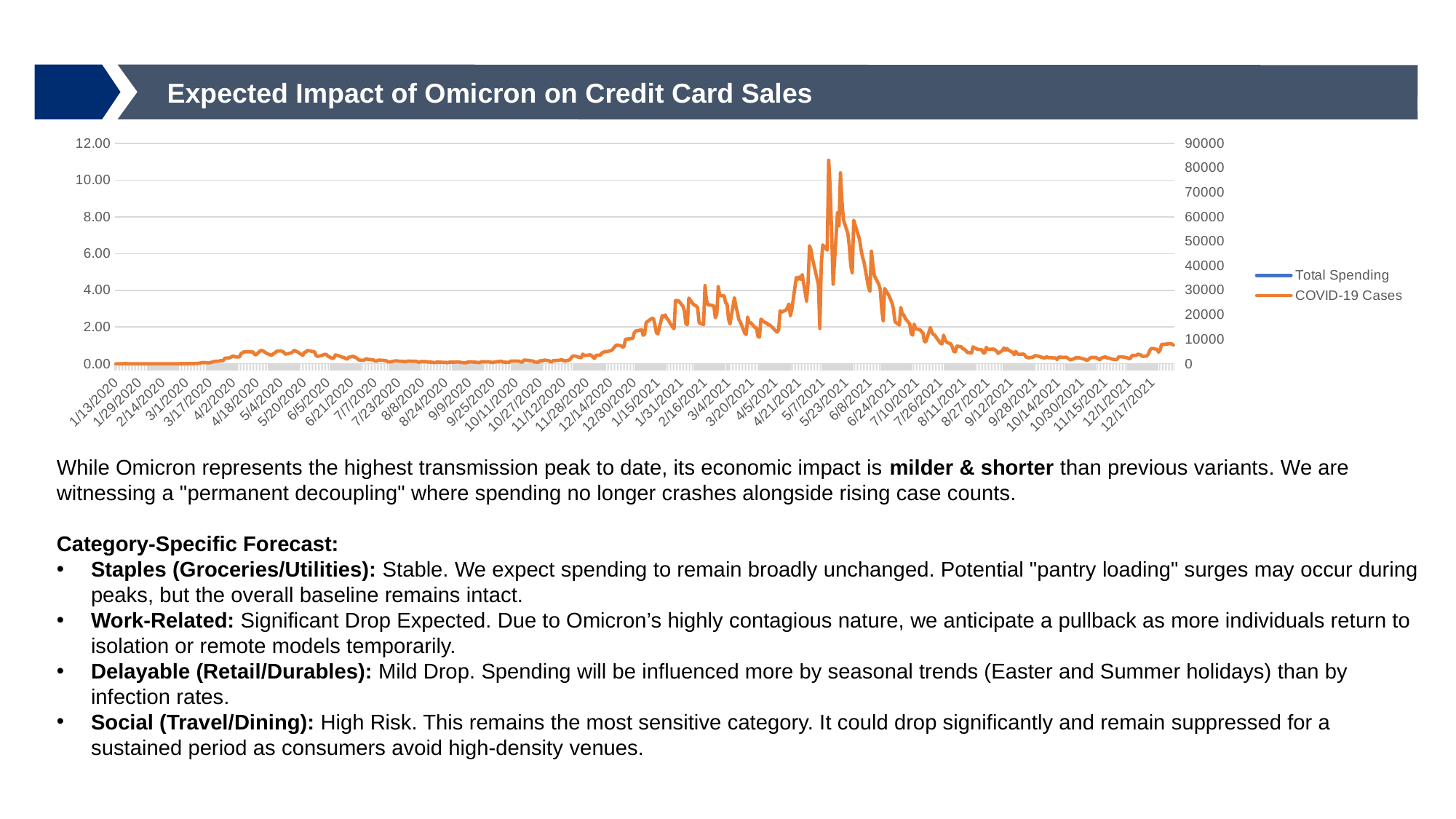
Which date has a higher COVID-19 Cases value, 5/7/2021 or 1/15/2021? 5/7/2021 What are the two series named in the chart legend? Total Spending and COVID-19 Cases What kind of chart is shown on the slide? line chart Between 11/12/2020 and 1/15/2021, does the COVID-19 Cases line generally rise or fall? rise What is the title of the chart on the slide? Expected Impact of Omicron on Credit Card Sales Which date has a higher COVID-19 Cases value, 3/4/2021 or 9/12/2021? 3/4/2021 Between 5/23/2021 and 9/12/2021, does the COVID-19 Cases line generally rise or fall? fall Around which labelled date does the COVID-19 Cases line reach its highest peak? 5/7/2021 Is the COVID-19 Cases value at 9/9/2020 greater or less than 10000 on the right axis? less Is the COVID-19 Cases value at 1/13/2020 greater or less than 10000 on the right axis? less Is the peak value of the COVID-19 Cases line greater or less than 70000 on the right axis? greater How many series does the chart legend list? 2